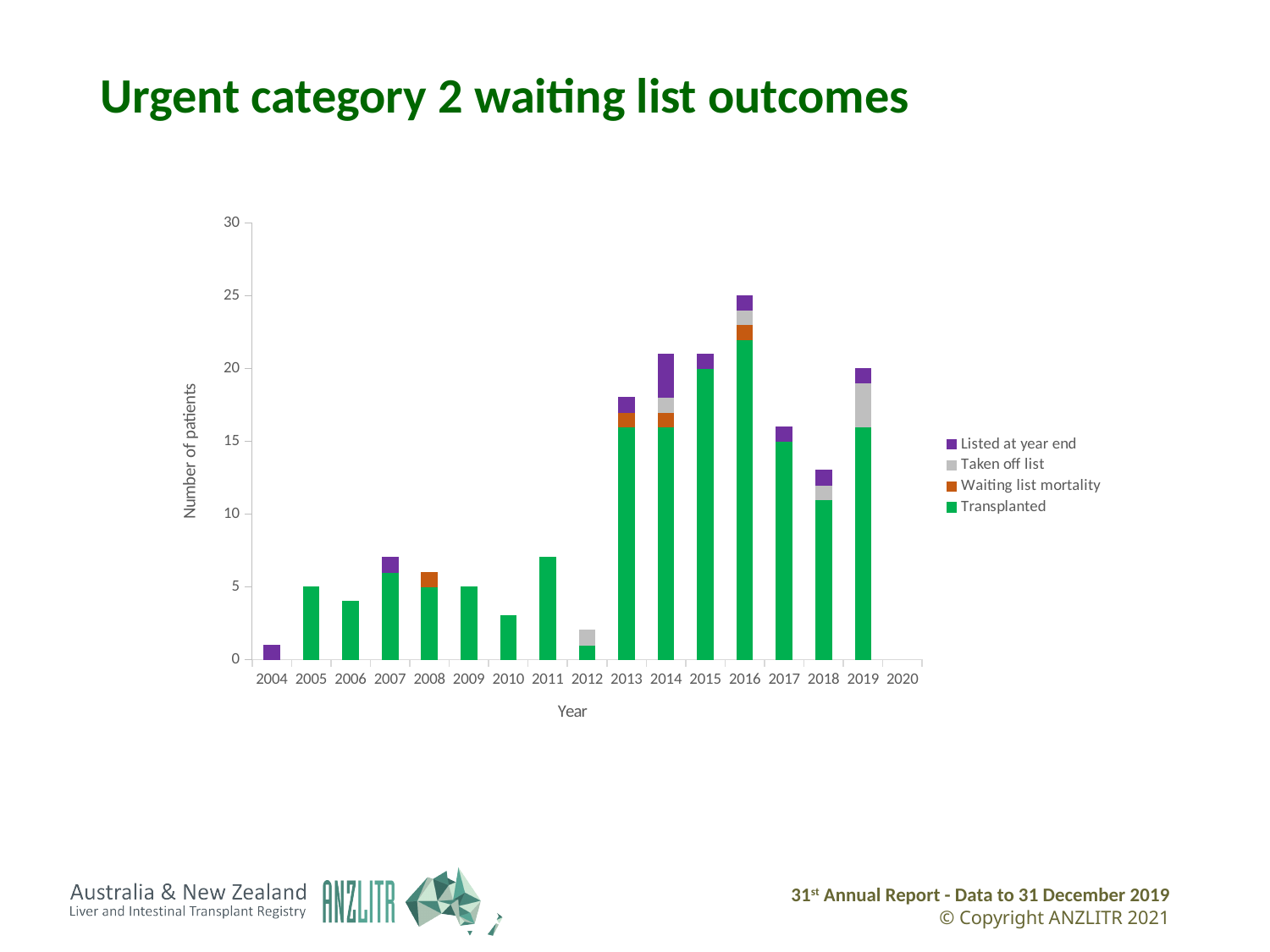
What is the label on the y axis? Number of patients Is the total value for 2012 greater or less than 5? less What kind of chart is shown on the slide? Stacked bar chart Is the total value for 2013 greater or less than 15? greater Which year has the larger total bar, 2014 or 2018? 2014 What is the total number of patients for 2019? 20 Which year has the tallest bar? 2016 What is the total number of patients for 2016? 25 Is the total value for 2018 greater or less than 10? greater What is the total number of patients for 2005? 5 How many years are labelled on the x axis? 17 How many series does the legend list? 4